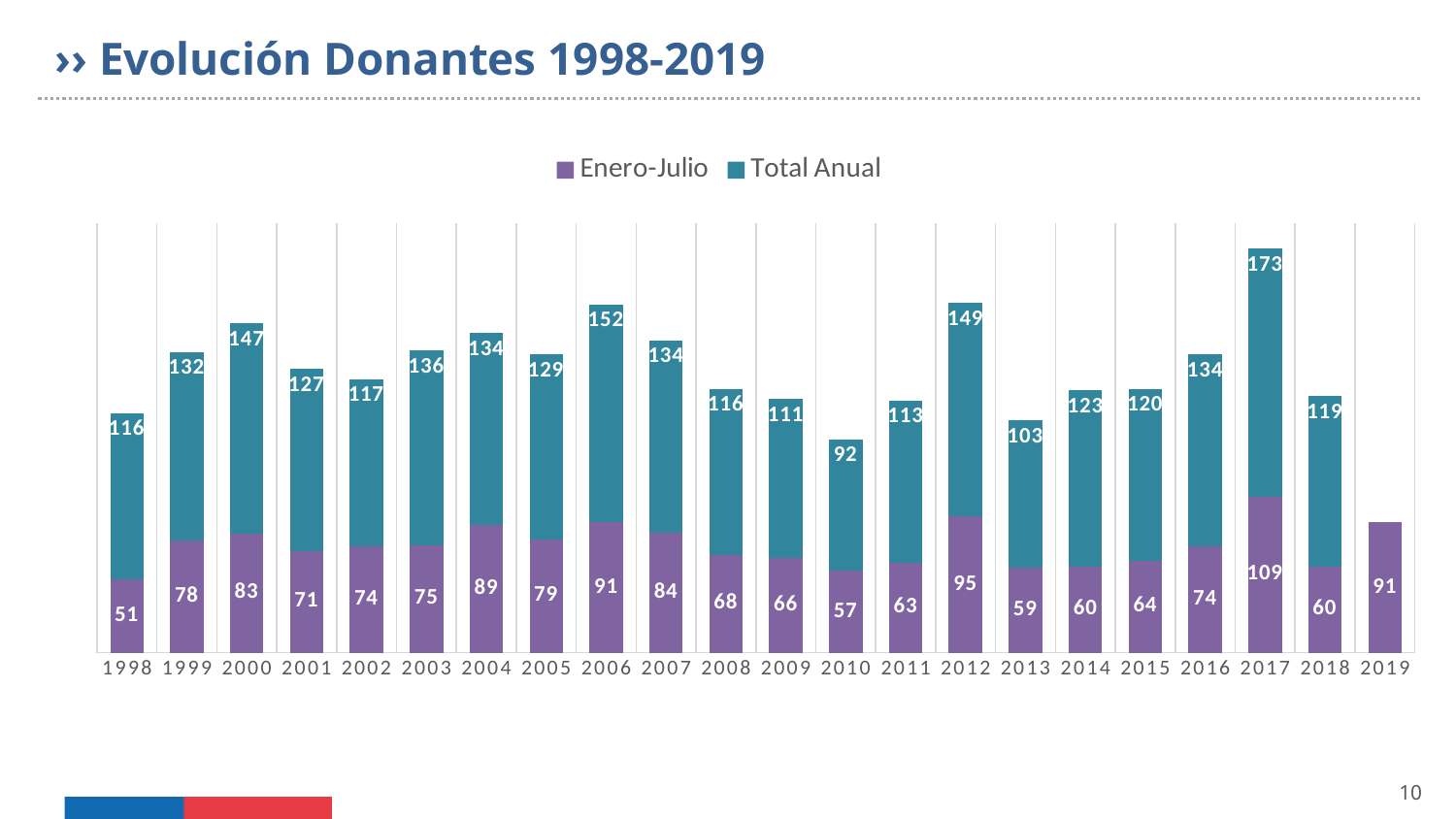
Which year has the lowest Total Anual value? 2010 How many years are shown on the x axis? 22 Which series is shown in purple? Enero-Julio Which is larger, the Enero-Julio value for 2006 or for 2004? 2006 What is the Enero-Julio value for 2012? 95 What kind of chart is shown on the slide? Stacked bar chart Which year has the lowest Enero-Julio value? 1998 What is the Total Anual value for 2010? 92 What is the difference between the Total Anual values for 2017 and 2018? 54 What is the Enero-Julio value for 2019? 91 How many series does the legend list? 2 Which year has the highest Total Anual value? 2017